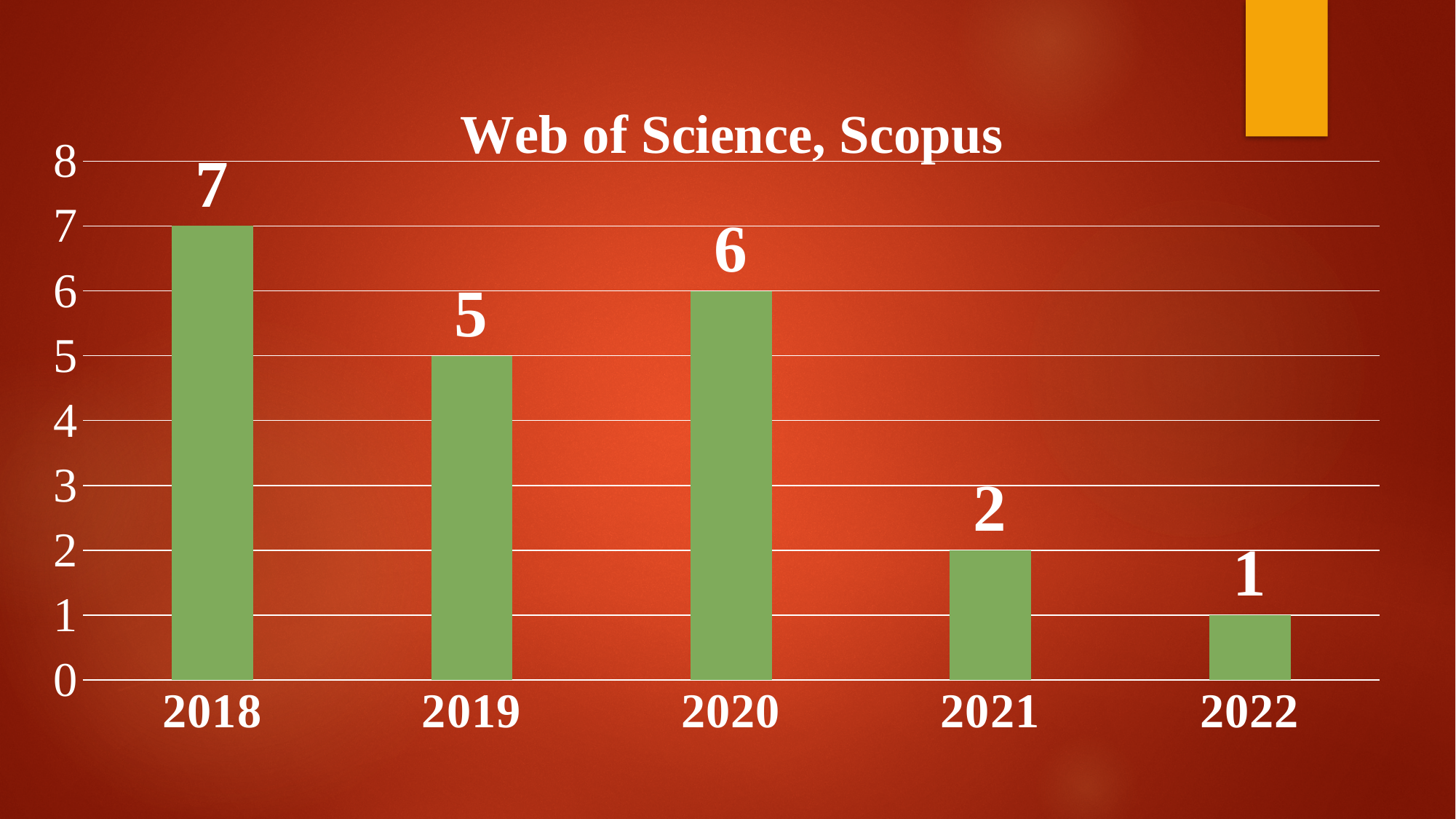
What is the difference between the values for 2018 and 2019? 2 What is the difference between the values for 2020 and 2021? 4 How many years are shown on the x axis? 5 What kind of chart is shown? bar chart What is the value for 2018? 7 Which is larger, the value for 2019 or the value for 2020? 2020 Which year has the lowest value? 2022 What is the value for 2020? 6 What is the value for 2022? 1 Which year has the highest value? 2018 Is the value for 2021 greater or less than 4? less What is the title of the chart? Web of Science, Scopus